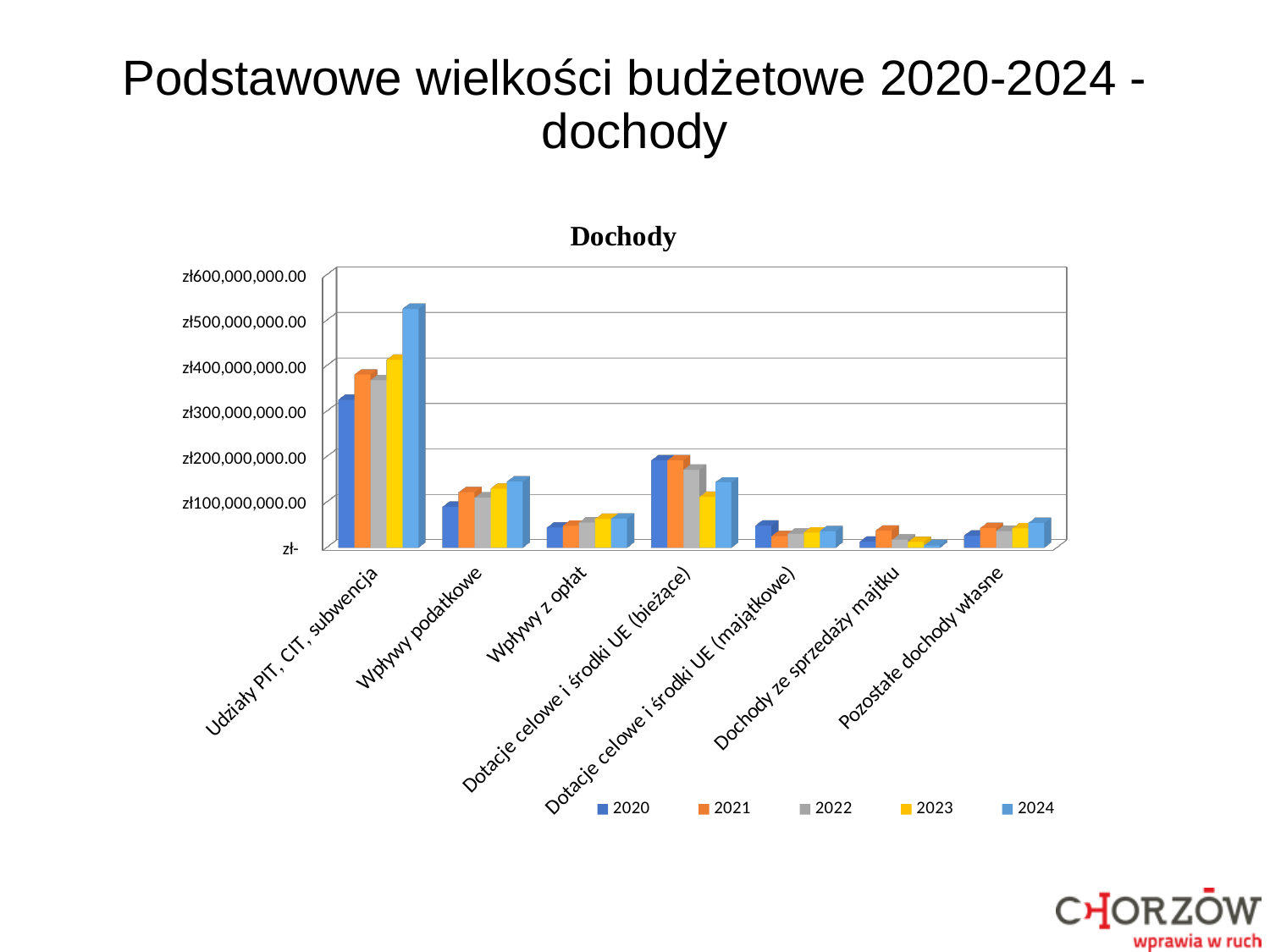
What is the title of the chart? Dochody For the category Dotacje celowe i środki UE (bieżące), which year has the lowest value? 2023 For the category Udziały PIT, CIT, subwencja, which year has the highest value? 2024 Which category has the highest bar in the chart? Udziały PIT, CIT, subwencja Is the 2024 value for Wpływy podatkowe greater or less than zł100,000,000.00? greater Is the 2020 value for Wpływy z opłat greater or less than zł100,000,000.00? less For Dochody ze sprzedaży majątku, which is larger: the 2021 value or the 2024 value? 2021 Which is larger in 2024: Wpływy podatkowe or Wpływy z opłat? Wpływy podatkowe How many series does the chart's legend list? 5 Is the 2024 value for Udziały PIT, CIT, subwencja greater or less than zł400,000,000.00? greater How many categories are shown on the x axis of the chart? 7 What kind of chart is shown on the slide? bar chart